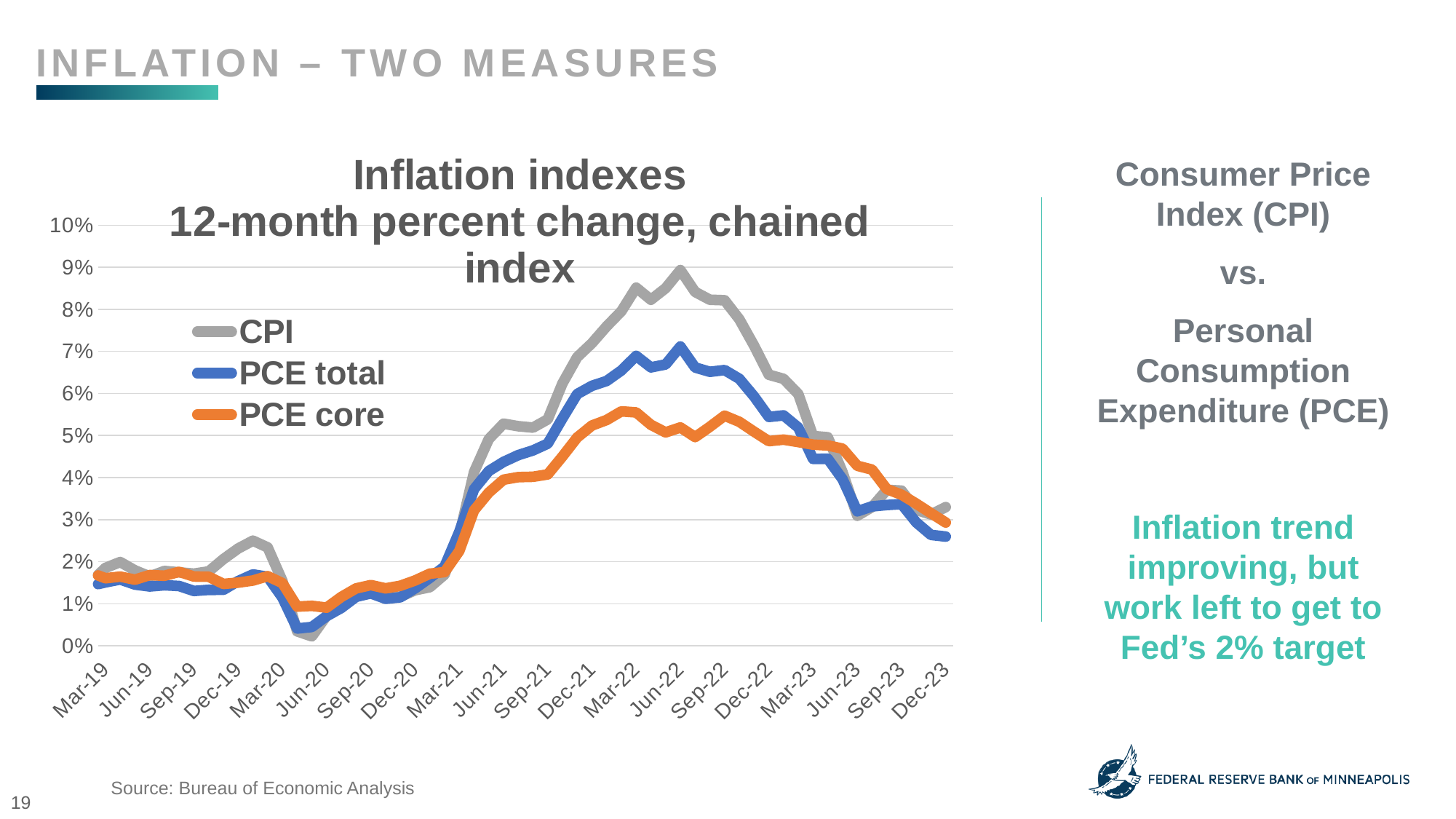
How many date labels are shown on the x axis? 20 Which series is drawn in orange? PCE core Which series reaches the highest peak on the chart? CPI What kind of chart is shown on the slide? line chart Is the value for CPI at Jun-22 greater or less than 8%? greater Is the value for PCE core at Mar-22 greater or less than 5%? greater Is the value for CPI at Jun-20 greater or less than 1%? less Which series has the lowest value at Dec-23? PCE total Does the CPI line rise or fall between Jun-22 and Dec-23? fall How many series does the chart legend list? 3 At Jun-22, which is larger: CPI or PCE core? CPI